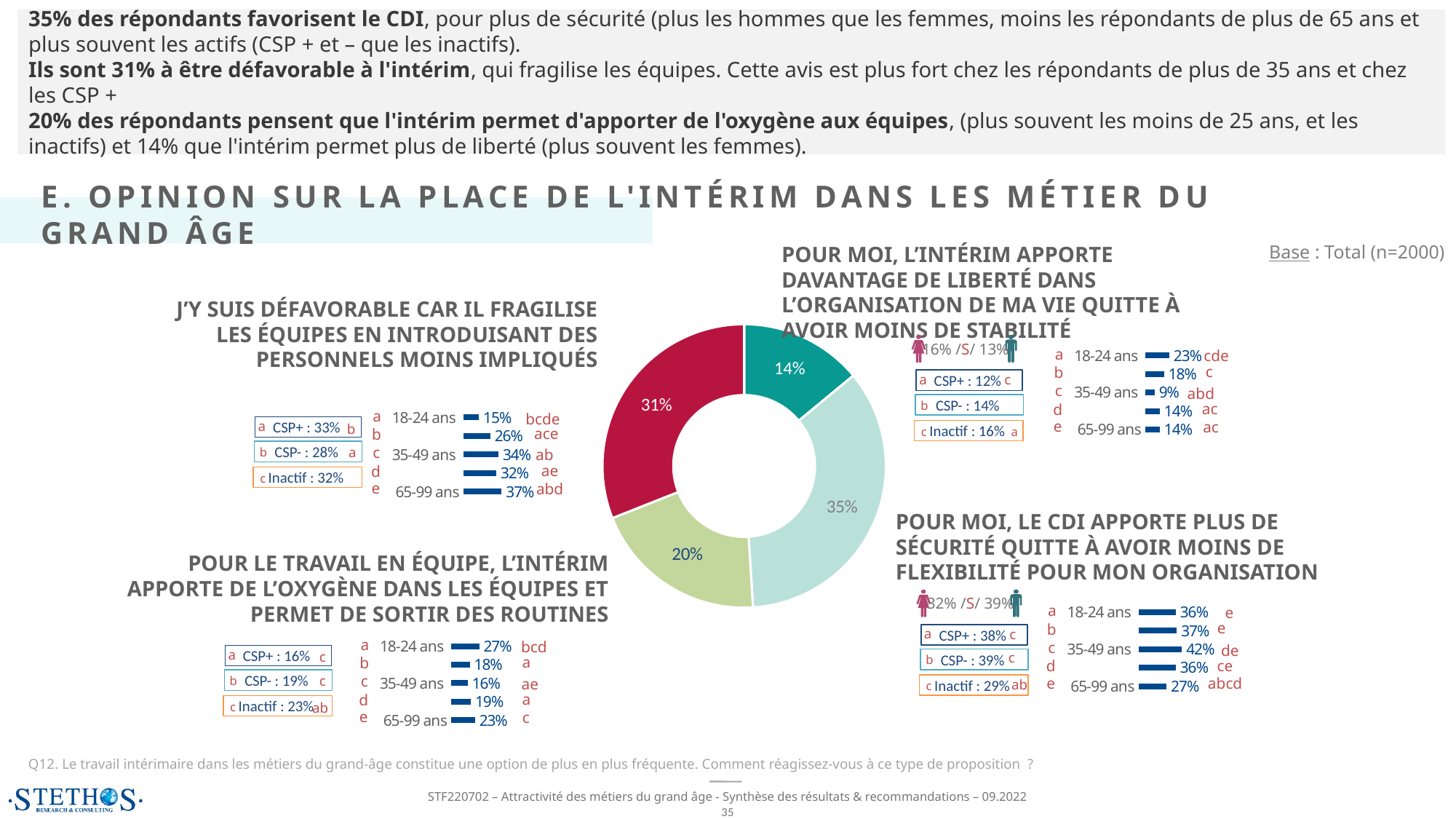
How many slices does the central doughnut chart have? 4 In the bar chart under 'J'y suis défavorable car il fragilise les équipes...', what is the value for 65-99 ans? 37% In the bar chart under 'Pour moi, le CDI apporte plus de sécurité...', which labelled age group has the highest value? 35-49 ans What kind of chart is the large chart in the centre of the slide? doughnut chart In the bar chart under 'Pour le travail en équipe, l'intérim apporte de l'oxygène...', which is larger: 18-24 ans or 65-99 ans? 18-24 ans In the central doughnut chart, what is the value of the smallest slice? 14% In the bar chart under 'Pour moi, l'intérim apporte davantage de liberté...', what is the value for 35-49 ans? 9% In the bar chart under 'Pour moi, l'intérim apporte davantage de liberté...', what is the value for 18-24 ans? 23% In the central doughnut chart, what colour is the 31% slice? red In the bar chart under 'Pour moi, le CDI apporte plus de sécurité...', what is the difference between 35-49 ans and 65-99 ans? 15 percentage points In the central doughnut chart, what is the difference between the 35% slice and the 31% slice? 4 percentage points In the central doughnut chart, what is the value of the largest slice? 35%